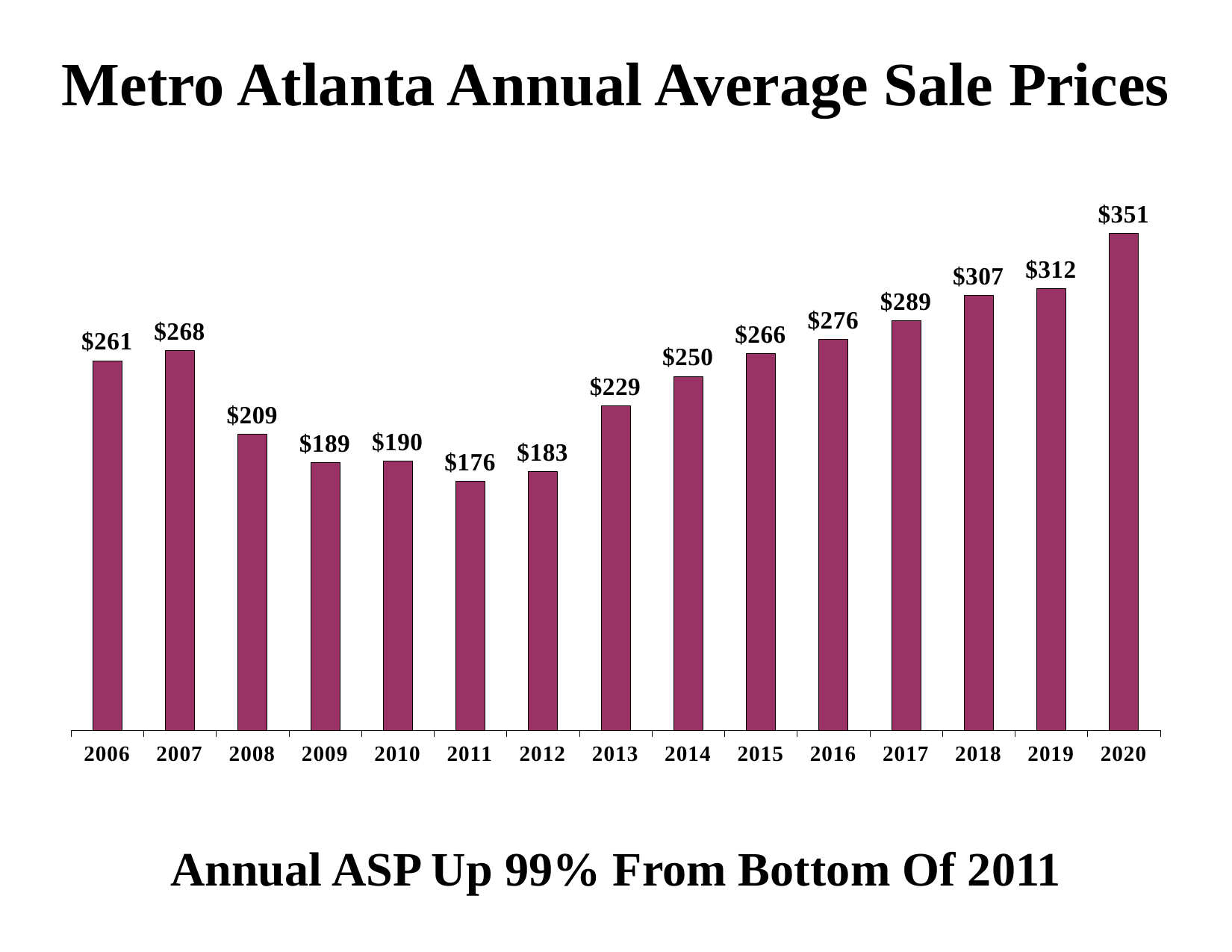
What is the title of the chart? Metro Atlanta Annual Average Sale Prices Which year has the lowest average sale price? 2011 What is the difference between the 2020 value and the 2011 value? $175 What is the difference between the 2007 value and the 2008 value? $59 What is the average sale price shown for 2011? $176 How many years are shown on the x axis? 15 What is the average sale price shown for 2016? $276 Do the values rise or fall from 2011 to 2020? rise According to the caption below the chart, by what percentage is annual ASP up from the bottom of 2011? 99% Which is larger, the value for 2006 or the value for 2015? 2015 Which year has the highest average sale price? 2020 What kind of chart is this? bar chart